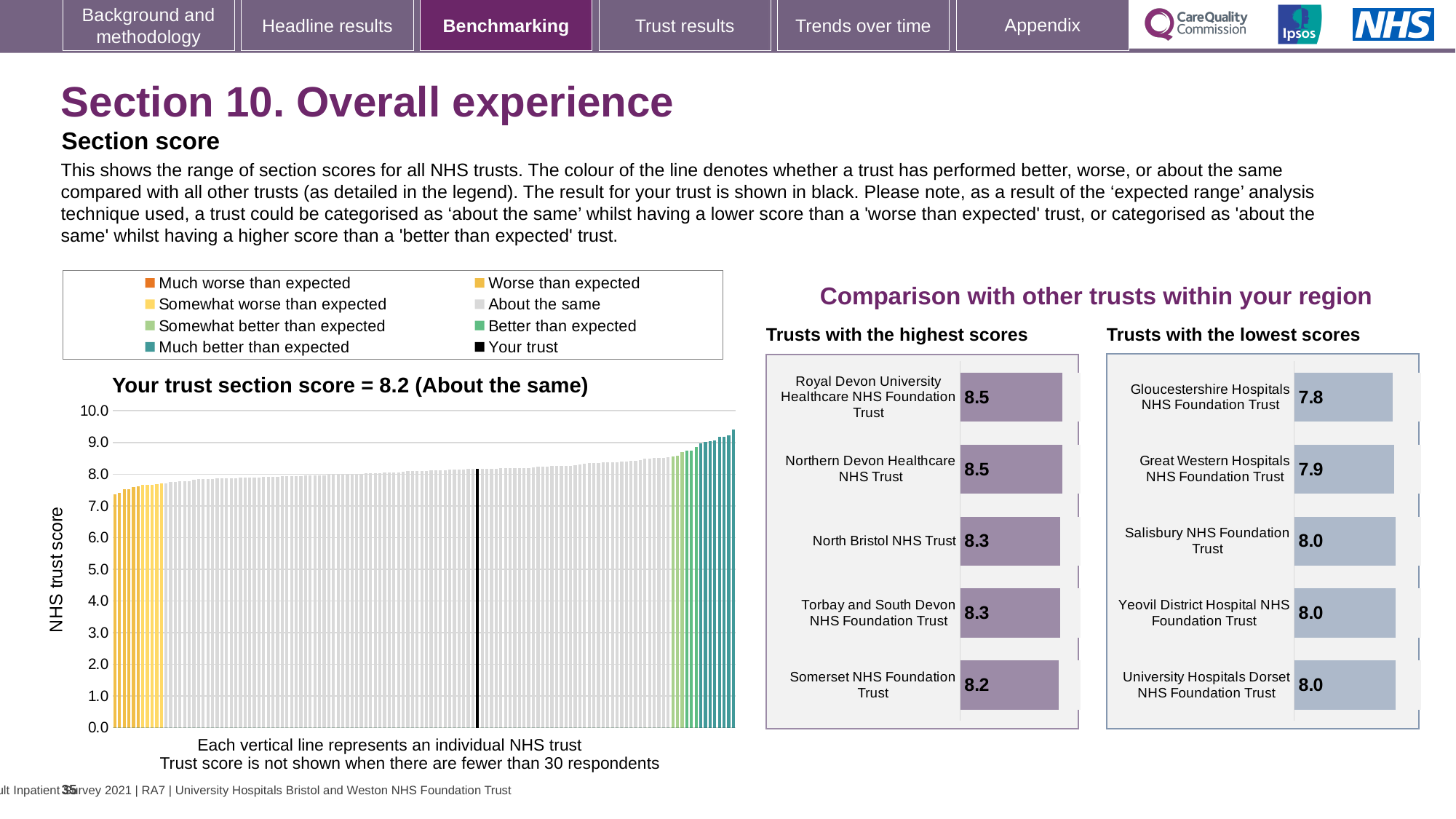
On the 'Your trust section score' chart, what is the section score for your trust? 8.2 How many entries does the legend above the 'Your trust section score' chart list? 8 What kind of chart is the 'Your trust section score' chart? Bar chart How many trusts are shown on the 'Trusts with the lowest scores' chart? 5 On the 'Your trust section score' chart, is the value of the lowest bar greater or less than 7.0? greater Which is larger: the score for Torbay and South Devon NHS Foundation Trust on the 'Trusts with the highest scores' chart, or the score for Great Western Hospitals NHS Foundation Trust on the 'Trusts with the lowest scores' chart? Torbay and South Devon NHS Foundation Trust On the 'Trusts with the lowest scores' chart, what is the difference between the score for Great Western Hospitals NHS Foundation Trust and the score for Gloucestershire Hospitals NHS Foundation Trust? 0.1 On the 'Trusts with the highest scores' chart, what is the score for Somerset NHS Foundation Trust? 8.2 On the 'Trusts with the highest scores' chart, what is the difference between the score for Royal Devon University Healthcare NHS Foundation Trust and the score for Somerset NHS Foundation Trust? 0.3 On the 'Trusts with the lowest scores' chart, which trust has the lowest score? Gloucestershire Hospitals NHS Foundation Trust On the 'Trusts with the lowest scores' chart, what is the score for Gloucestershire Hospitals NHS Foundation Trust? 7.8 On the 'Trusts with the highest scores' chart, what is the score for North Bristol NHS Trust? 8.3